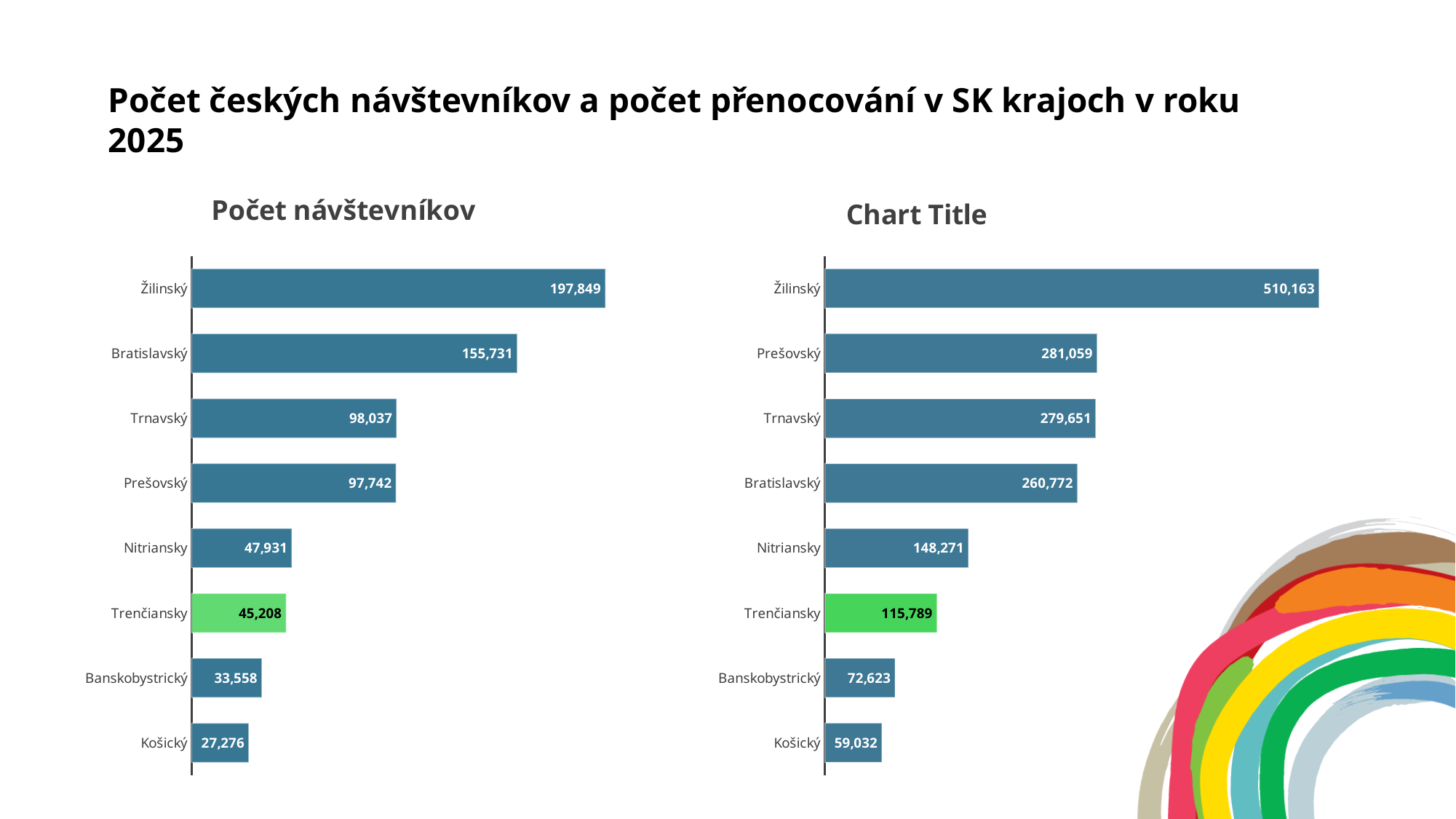
In the 'Chart Title' chart, which is larger, the value for Bratislavský or the value for Trnavský? Trnavský In the 'Počet návštevníkov' chart, what is the value for Trenčiansky? 45,208 In the 'Chart Title' chart, what is the value for Nitriansky? 148,271 In the 'Chart Title' chart, which category has the highest value? Žilinský In the 'Počet návštevníkov' chart, what is the value for Bratislavský? 155,731 What kind of chart is the 'Počet návštevníkov' chart? Bar chart In the 'Počet návštevníkov' chart, what is the difference between the values for Žilinský and Bratislavský? 42,118 In the 'Chart Title' chart, what is the difference between the values for Prešovský and Trnavský? 1,408 In the 'Počet návštevníkov' chart, which is larger, the value for Nitriansky or the value for Banskobystrický? Nitriansky In the 'Chart Title' chart, which category's bar is coloured green? Trenčiansky In the 'Počet návštevníkov' chart, which category has the lowest value? Košický How many categories are shown in the 'Chart Title' chart? 8